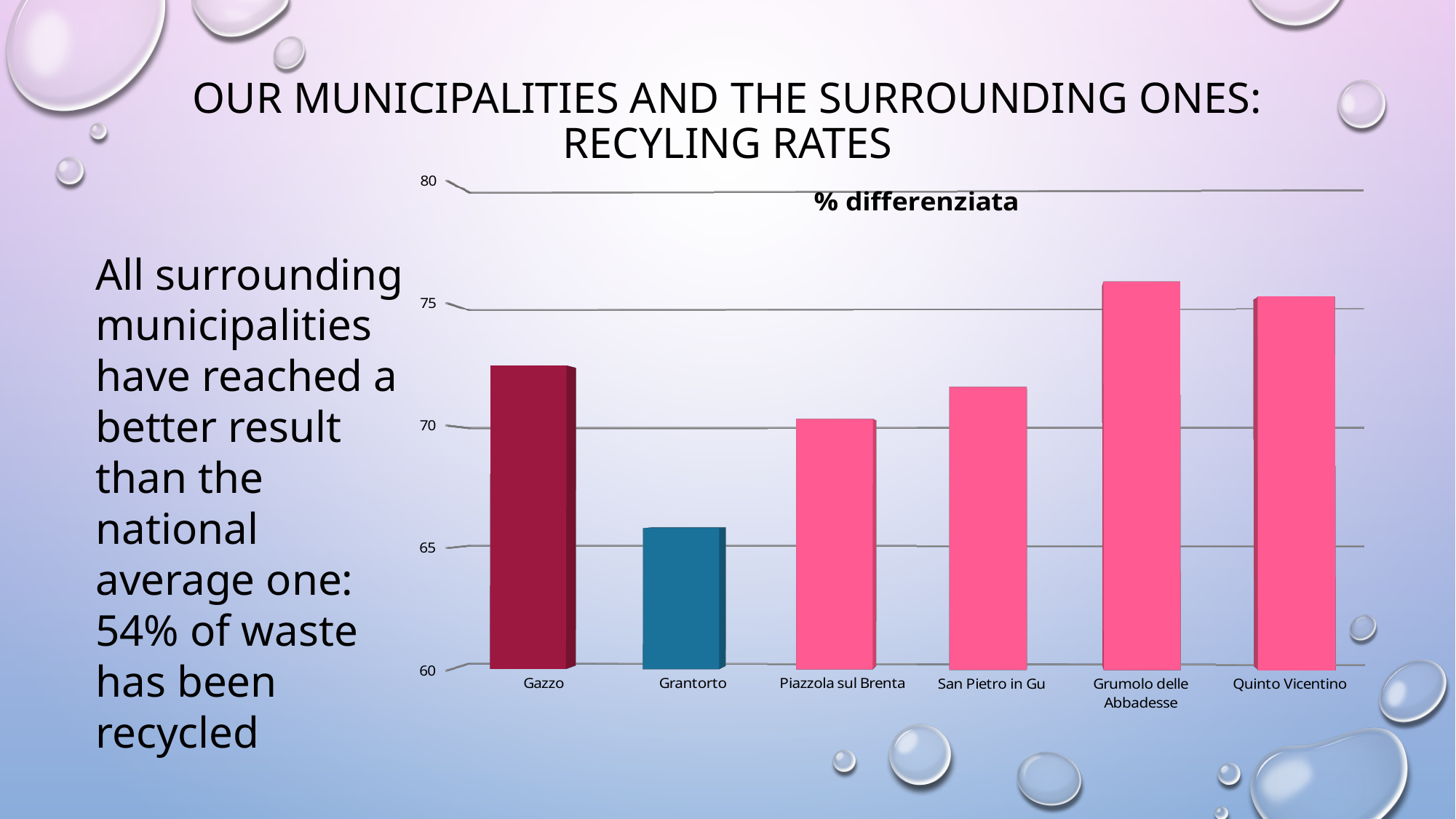
Which has a higher recycling rate, Grantorto or San Pietro in Gu? San Pietro in Gu What colour is the bar for Grantorto? blue What is the title of the chart? % differenziata Is the value for Grumolo delle Abbadesse greater or less than 75? greater Which municipality has the highest recycling rate in the chart? Grumolo delle Abbadesse Is the value for San Pietro in Gu greater or less than 75? less What kind of chart is shown on the slide? bar chart Which municipality has the lowest recycling rate in the chart? Grantorto How many municipalities are shown on the x axis of the chart? 6 Is the value for Grantorto greater or less than 70? less Which has a higher recycling rate, Gazzo or Piazzola sul Brenta? Gazzo